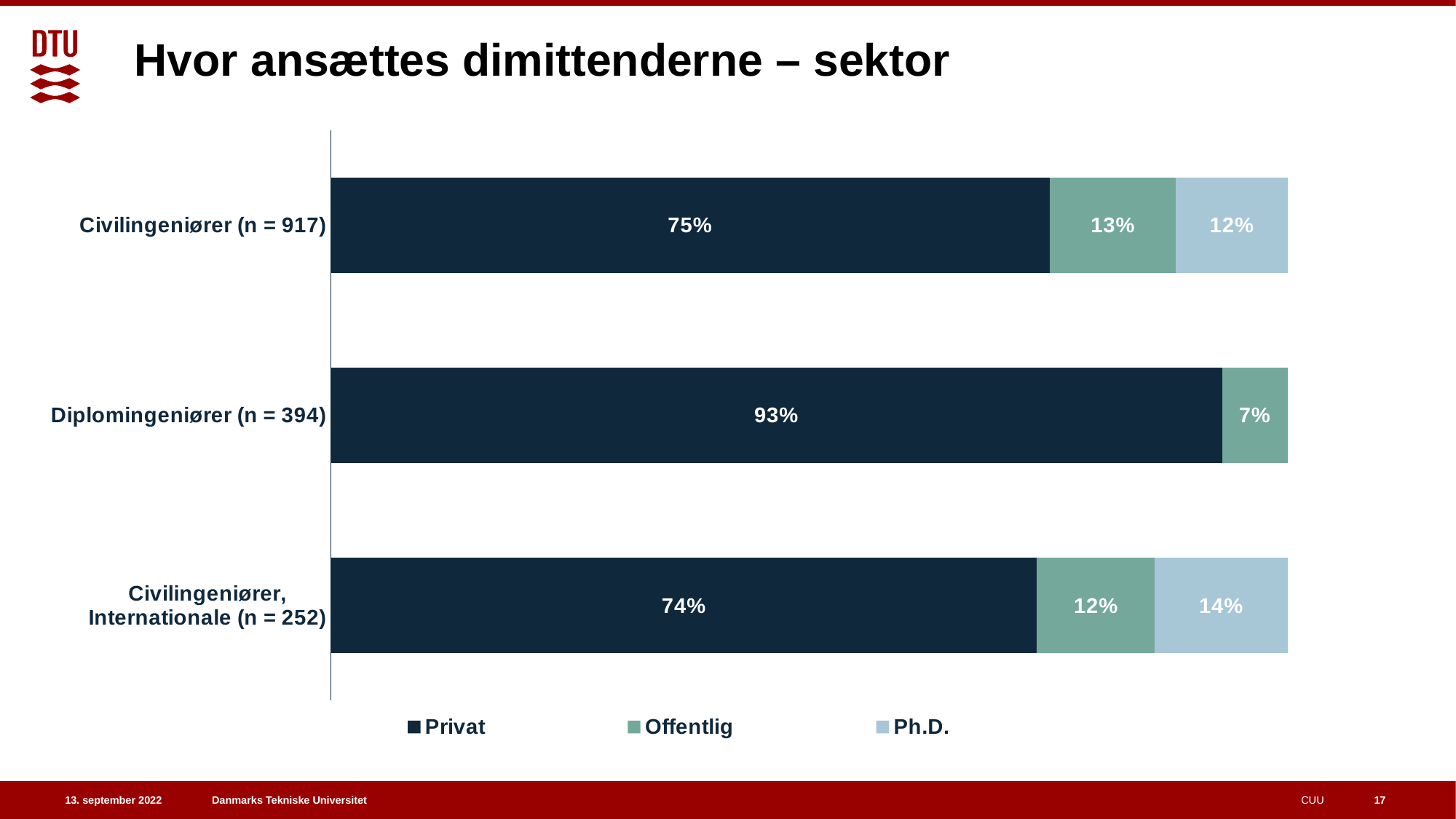
Which category has the lowest Privat share? Civilingeniører, Internationale (n = 252) What is the Privat share for Civilingeniører (n = 917)? 75% What is the total of the stacked bar for Civilingeniører (n = 917)? 100% Which is larger: the Ph.D. share for Civilingeniører (n = 917) or for Civilingeniører, Internationale (n = 252)? Civilingeniører, Internationale (n = 252) What is the Ph.D. share for Civilingeniører, Internationale (n = 252)? 14% Which category has the highest Privat share? Diplomingeniører (n = 394) How many categories are shown on the chart? 3 What is the title of the chart on the slide? Hvor ansættes dimittenderne – sektor What is the difference between the Privat share for Diplomingeniører (n = 394) and for Civilingeniører (n = 917)? 18 percentage points What kind of chart is shown on the slide? Stacked bar chart How many series does the legend list? 3 What is the Offentlig share for Diplomingeniører (n = 394)? 7%